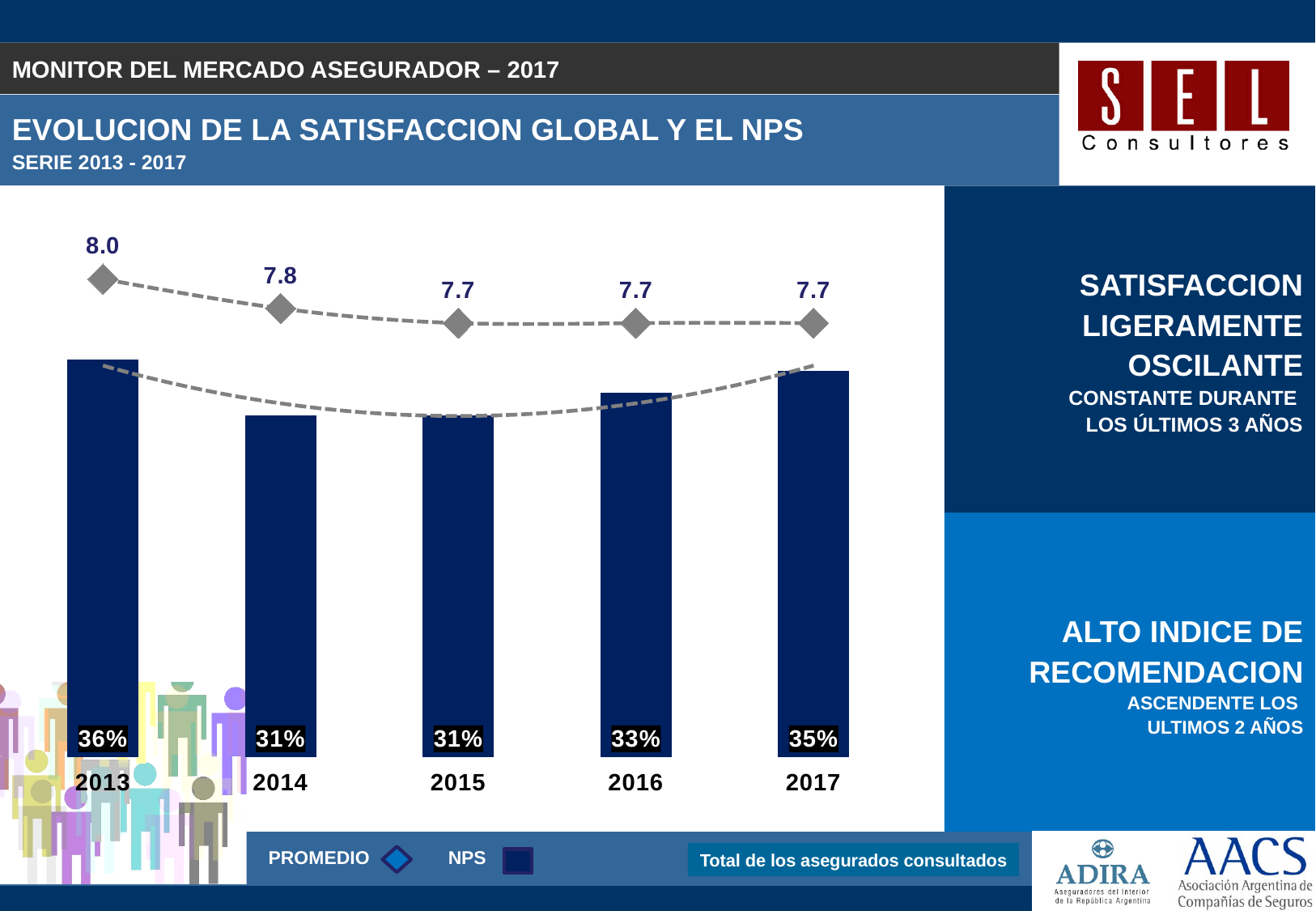
How many years are shown on the x axis? 5 Which is larger, the NPS value for 2016 or the NPS value for 2014? 2016 What is the difference between the PROMEDIO values for 2013 and 2015? 0.3 What is the NPS value for 2017? 35% What are the two series named in the legend? PROMEDIO and NPS Which year has the highest NPS value? 2013 Does the NPS value rise or fall from 2015 to 2017? rise What is the NPS value for 2013? 36% Which year has the highest PROMEDIO value? 2013 How many series does the legend list? 2 What is the difference between the NPS values for 2017 and 2016? 2% What is the PROMEDIO value for 2014? 7.8